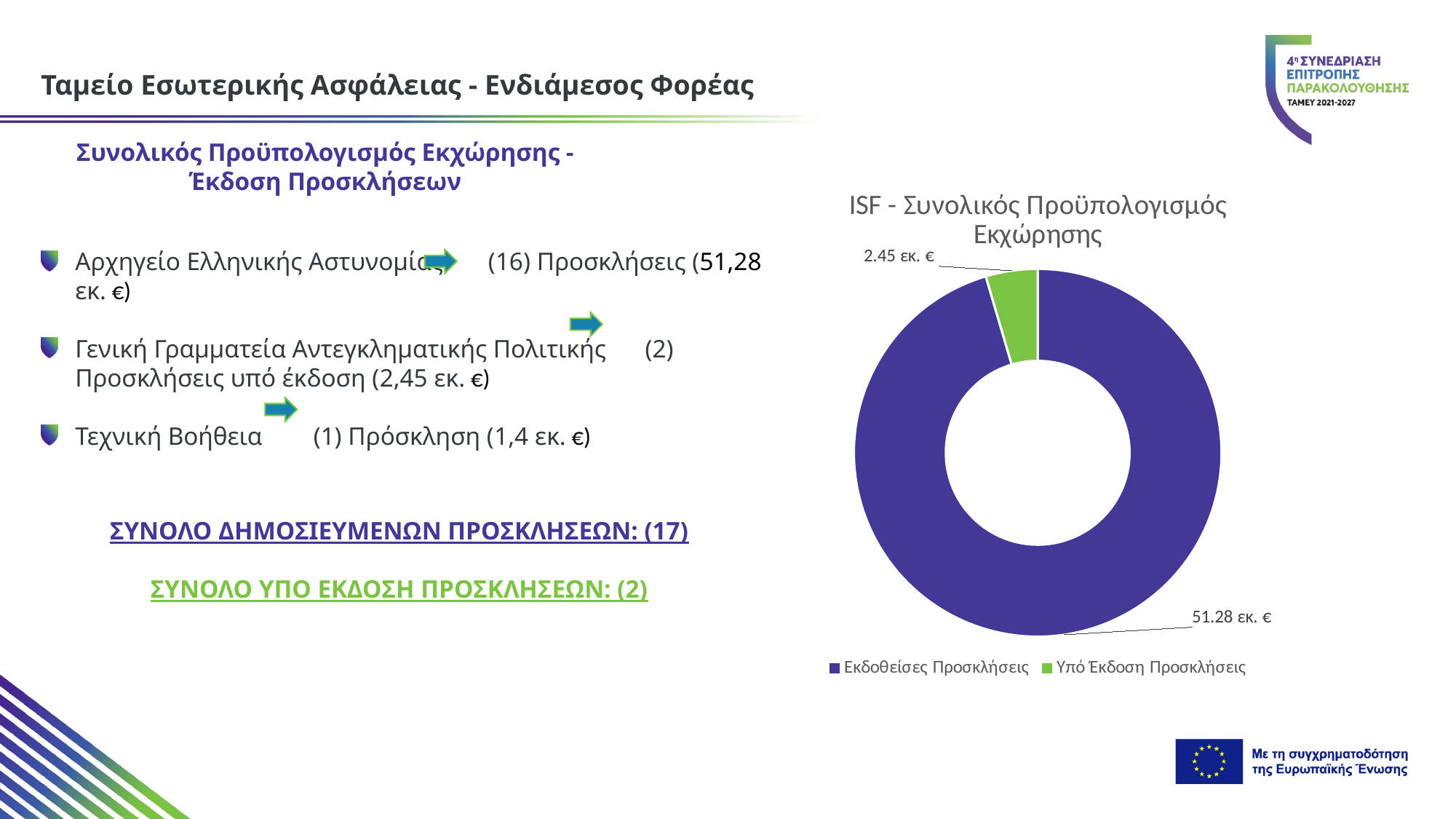
Which is larger: Εκδοθείσες Προσκλήσεις or Υπό Έκδοση Προσκλήσεις? Εκδοθείσες Προσκλήσεις Which category has the smallest slice in the chart? Υπό Έκδοση Προσκλήσεις What is the title of the chart? ISF - Συνολικός Προϋπολογισμός Εκχώρησης What is the value for Εκδοθείσες Προσκλήσεις in the chart? 51.28 εκ. € How many entries does the chart legend list? 2 What is the difference between the values for Εκδοθείσες Προσκλήσεις and Υπό Έκδοση Προσκλήσεις? 48.83 εκ. € What colour is the slice for Υπό Έκδοση Προσκλήσεις? green Which category has the largest slice in the chart? Εκδοθείσες Προσκλήσεις What type of chart is shown on the slide? doughnut chart What is the total of the two values shown in the chart? 53.73 εκ. € What is the value for Υπό Έκδοση Προσκλήσεις in the chart? 2.45 εκ. € How many slices does the chart have? 2